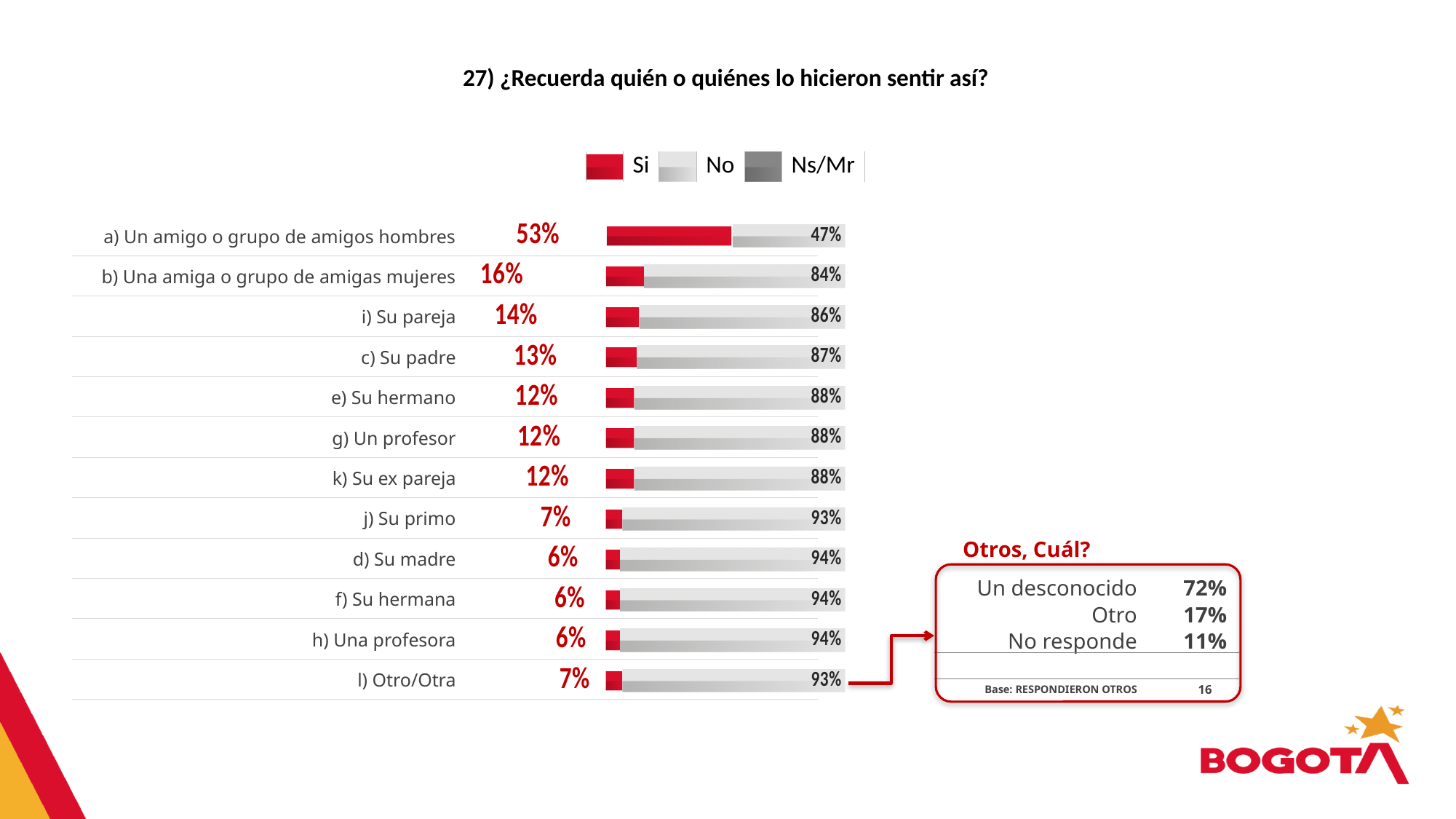
Which series is shown in red in the legend? Si What is the difference between the 'Si' values for 'a) Un amigo o grupo de amigos hombres' and 'b) Una amiga o grupo de amigas mujeres'? 37% What is the 'No' value for 'i) Su pareja'? 86% What is the total of the 'Si' and 'No' values for 'e) Su hermano'? 100% Which category has the highest 'Si' value? a) Un amigo o grupo de amigos hombres Which is larger, the 'Si' value for 'c) Su padre' or for 'd) Su madre'? c) Su padre Which category has the lowest 'No' value? a) Un amigo o grupo de amigos hombres What is the 'Si' value for 'j) Su primo'? 7% What kind of chart is shown on the slide? Stacked bar chart How many categories are shown in the bar chart? 12 What is the 'Si' value for 'a) Un amigo o grupo de amigos hombres'? 53% How many series does the legend list? 3